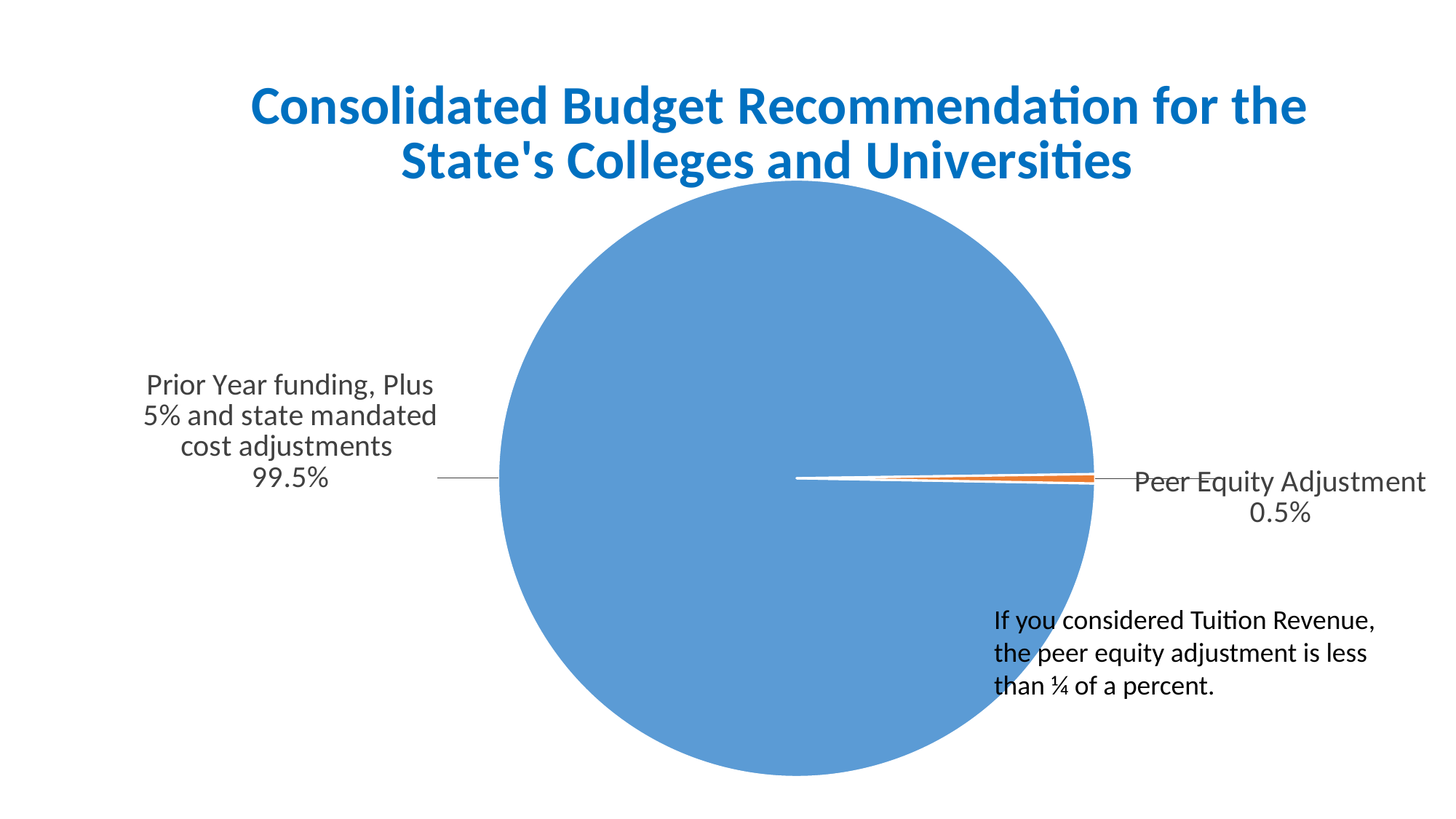
How many slices does the pie chart have? 2 Which slice of the pie is the largest? Prior Year funding, Plus 5% and state mandated cost adjustments What is the title of the chart? Consolidated Budget Recommendation for the State's Colleges and Universities What colour is the Peer Equity Adjustment slice? orange What share of the pie does 'Prior Year funding, Plus 5% and state mandated cost adjustments' represent? 99.5% What share of the pie does Peer Equity Adjustment represent? 0.5% What is the difference in percentage points between the Prior Year funding slice and the Peer Equity Adjustment slice? 99 percentage points Which is larger: the Peer Equity Adjustment slice or the Prior Year funding slice? Prior Year funding, Plus 5% and state mandated cost adjustments What kind of chart is shown on the slide? pie chart What do the two slices of the pie add up to? 100% Which slice of the pie is the smallest? Peer Equity Adjustment